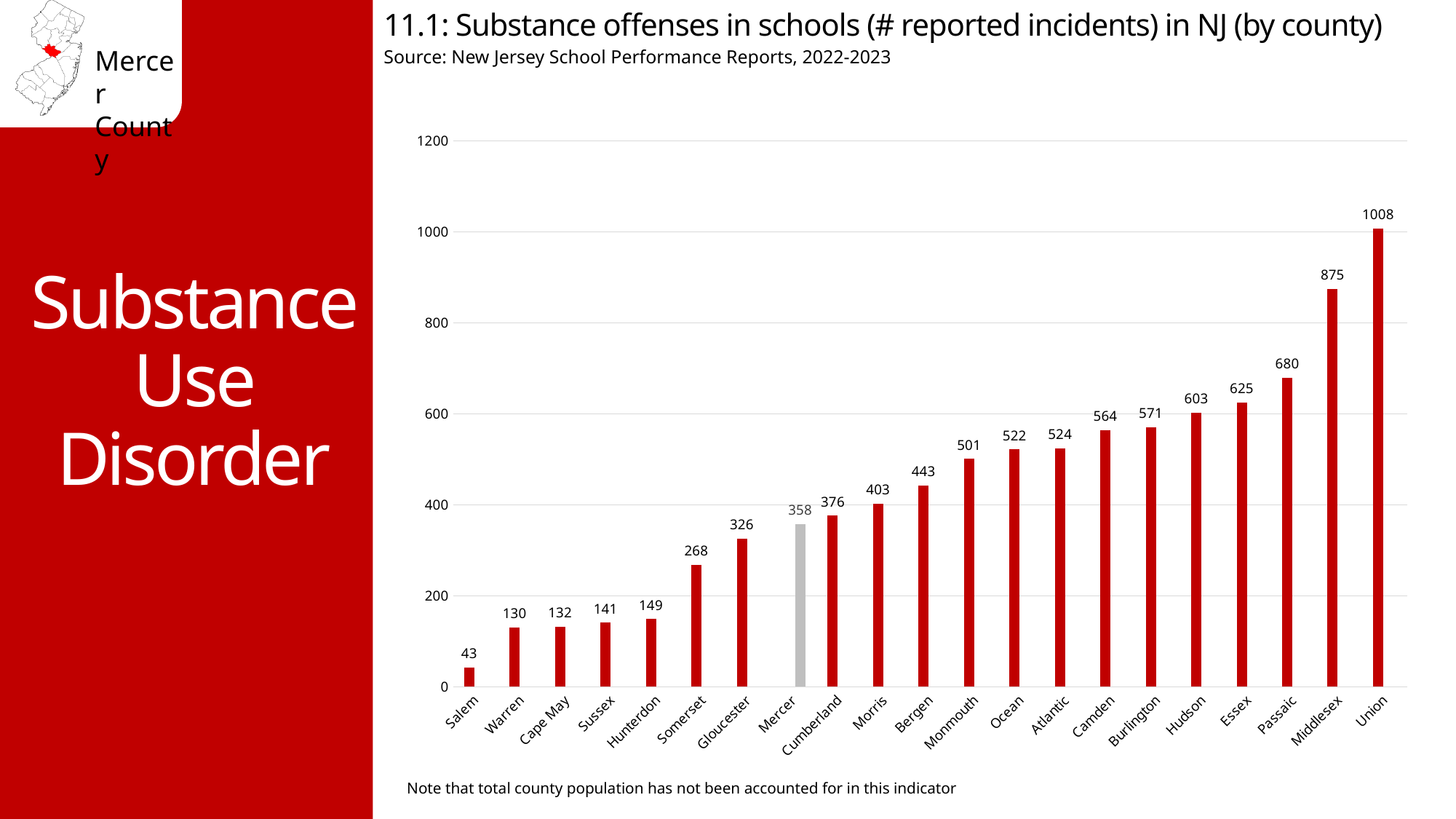
What kind of chart is shown on the slide? Bar chart Is the value for Passaic greater or less than 600? greater What is the difference between the values for Mercer and Gloucester? 32 How many reported substance offense incidents in schools does the chart show for Mercer County? 358 What is the difference between the values for Union and Middlesex? 133 Do the values rise or fall moving from left to right along the x axis? Rise Which bar is coloured grey instead of red? Mercer Which county has the highest number of reported incidents? Union What is the value shown for Middlesex? 875 Which county has the lowest number of reported incidents? Salem Which has more reported incidents, Bergen or Morris? Bergen How many counties are shown on the x axis of the chart? 21